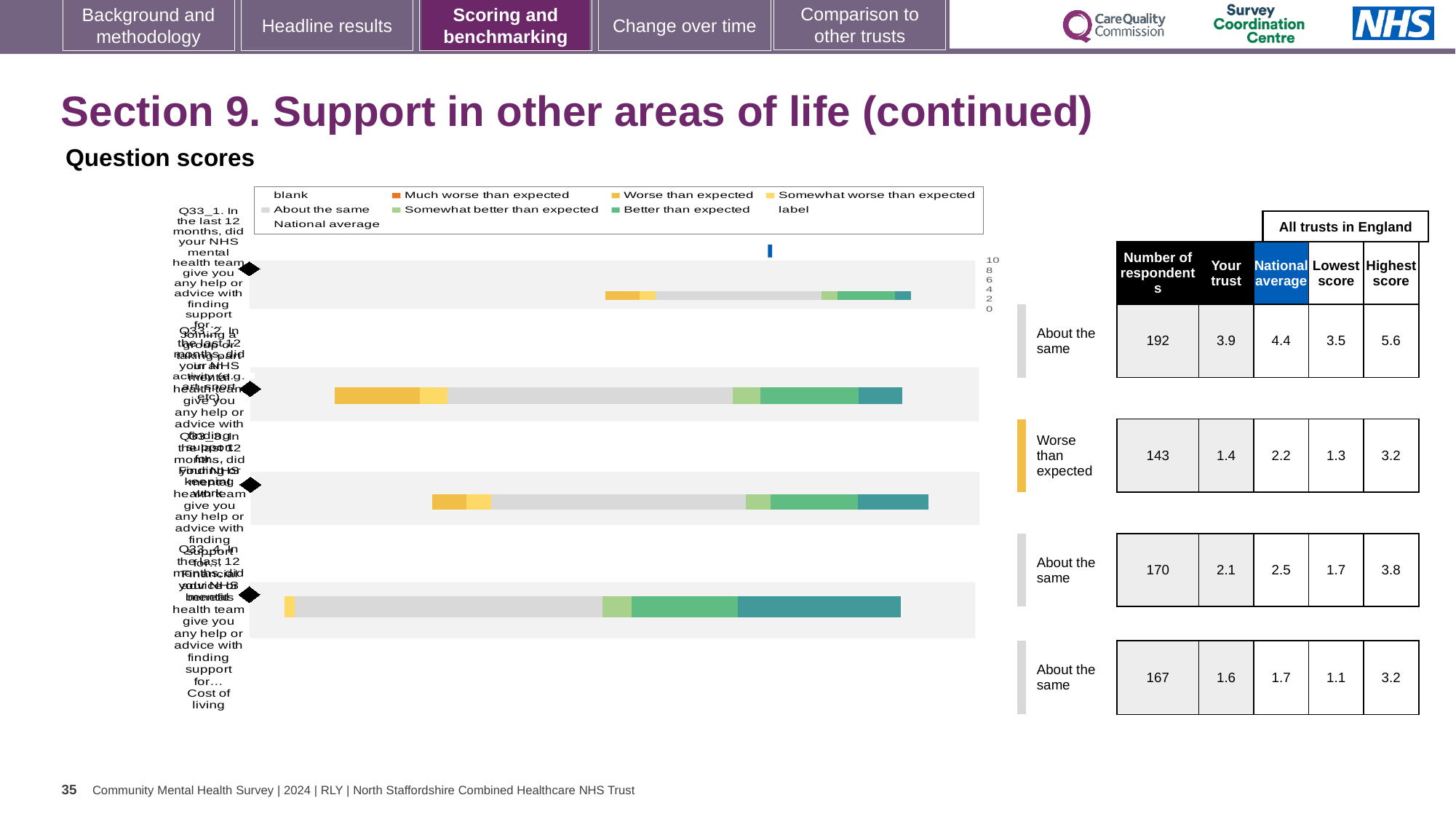
Which row in the table beside the chart has the lowest number of respondents? the second row (143) Which row in the table beside the chart has the highest number of respondents? the first row (192) How many question bars are plotted in the chart? 4 What benchmark label is shown next to the second bar from the top? Worse than expected In the table beside the chart, what is the 'Your trust' score for the second row? 1.4 How many entries does the chart legend list? 9 In the table beside the chart, what is the number of respondents for the top bar (first row)? 192 Which legend entry is shown in dark orange? Much worse than expected What kind of chart is shown under 'Question scores'? bar chart In the table beside the chart, what is the highest score for the bottom row (fourth row)? 3.2 In the table beside the chart, what is the national average for the third row? 2.5 In the first row of the table beside the chart, what is the difference between the national average (4.4) and the trust score (3.9)? 0.5